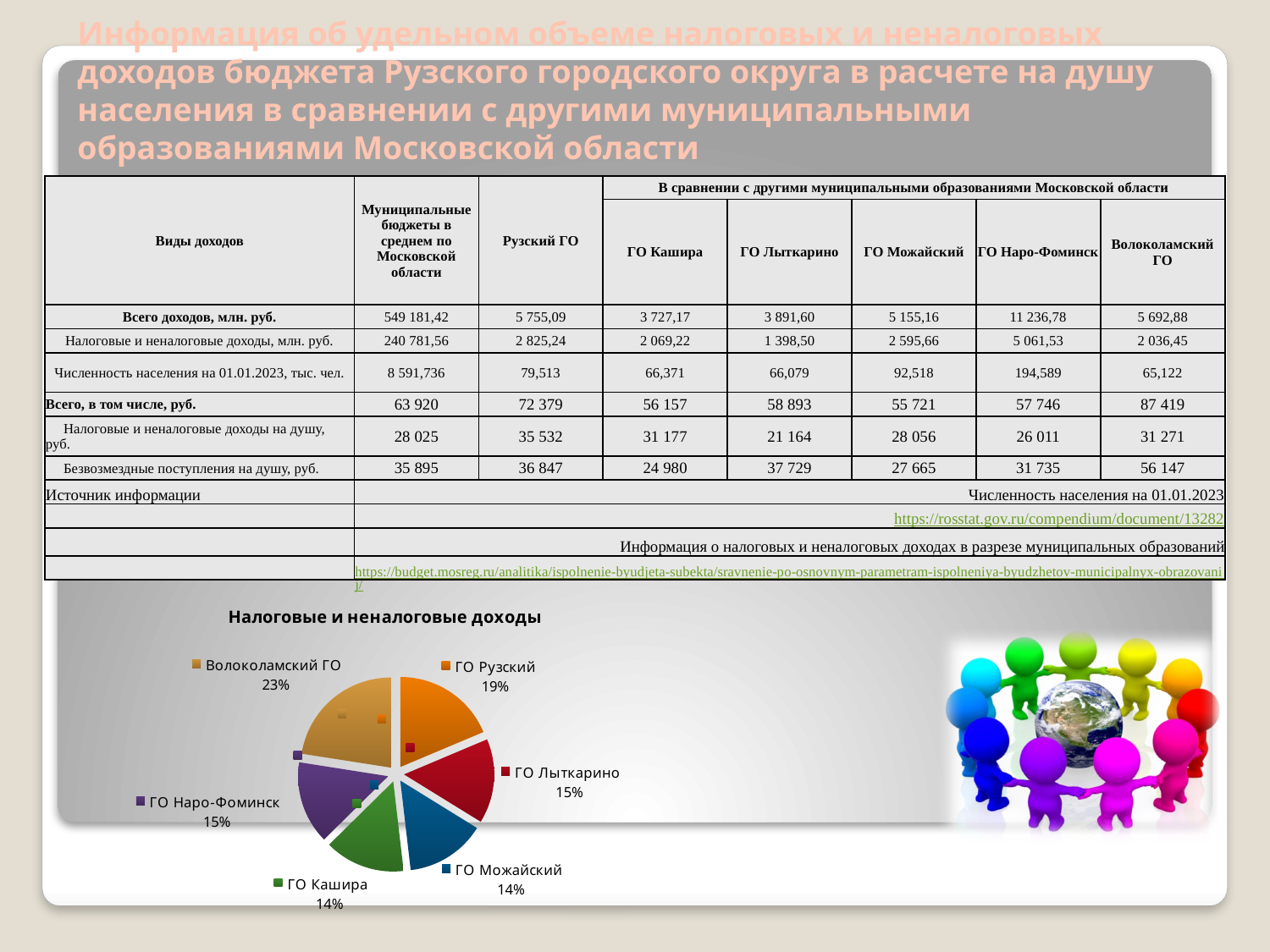
What share of the pie does Волоколамский ГО have? 23% Which slice of the pie chart is the largest? Волоколамский ГО What is the title of the pie chart? Налоговые и неналоговые доходы What kind of chart is shown on the slide? pie chart Which has a larger share in the pie chart, Волоколамский ГО or ГО Рузский? Волоколамский ГО What share of the pie does ГО Лыткарино have? 15% What is the difference in percentage points between the shares of Волоколамский ГО and ГО Рузский? 4 What share of the pie does ГО Можайский have? 14% What is the difference in percentage points between the shares of ГО Рузский and ГО Кашира? 5 How many slices does the pie chart have? 6